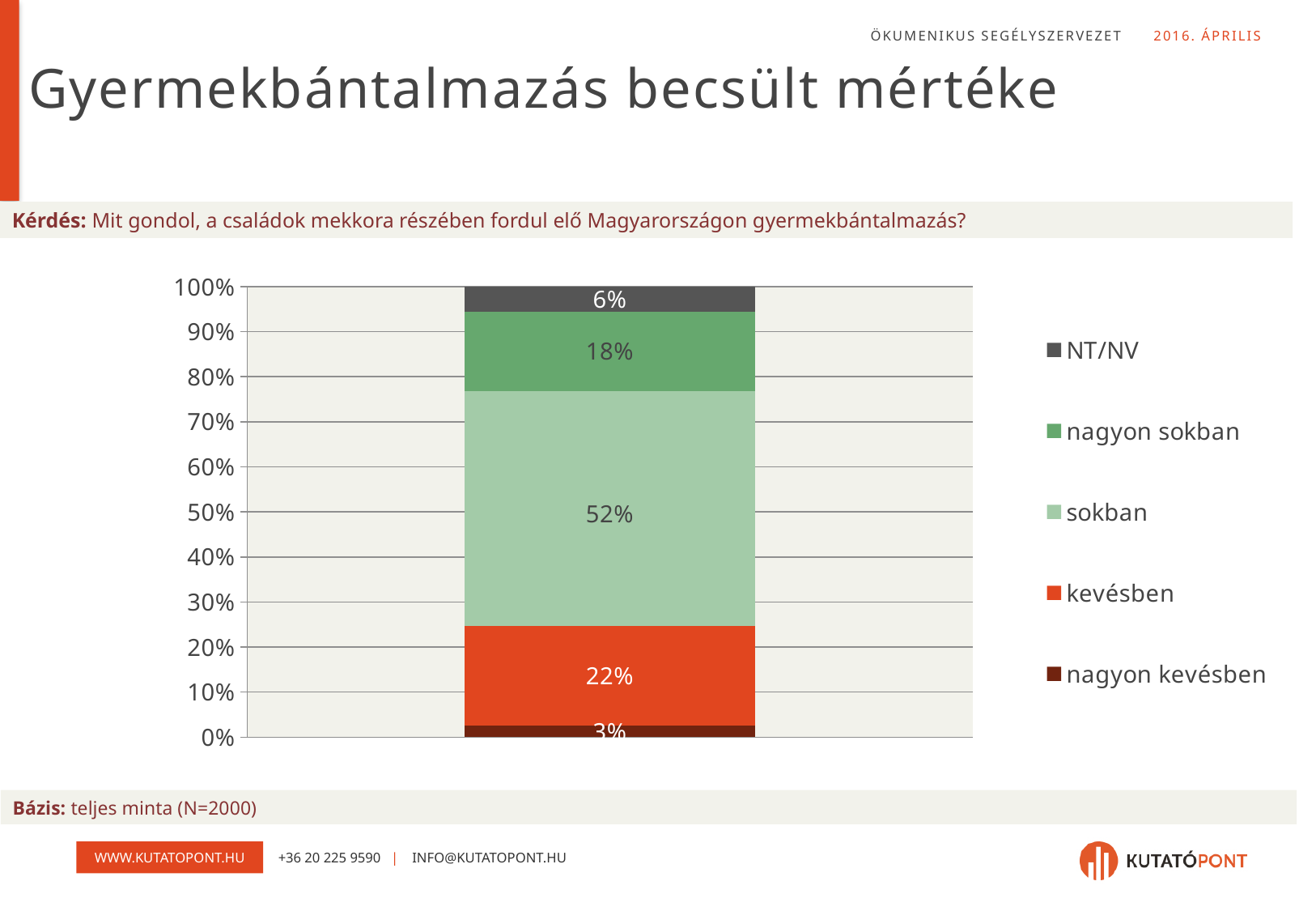
What is the value shown for "nagyon kevésben"? 3% What is the value shown for "kevésben"? 22% How many series does the legend list? 5 Which response category has the smallest share in the bar? nagyon kevésben What is the difference between the "sokban" and "kevésben" values? 30% What is the value shown for "NT/NV"? 6% What kind of chart is shown on the slide? stacked bar chart What percentage of respondents answered "sokban"? 52% What is the value shown for "nagyon sokban"? 18% Which is larger, the value for "nagyon sokban" or the value for "kevésben"? kevésben Which response category has the largest share in the bar? sokban What is the title of the slide containing the chart? Gyermekbántalmazás becsült mértéke